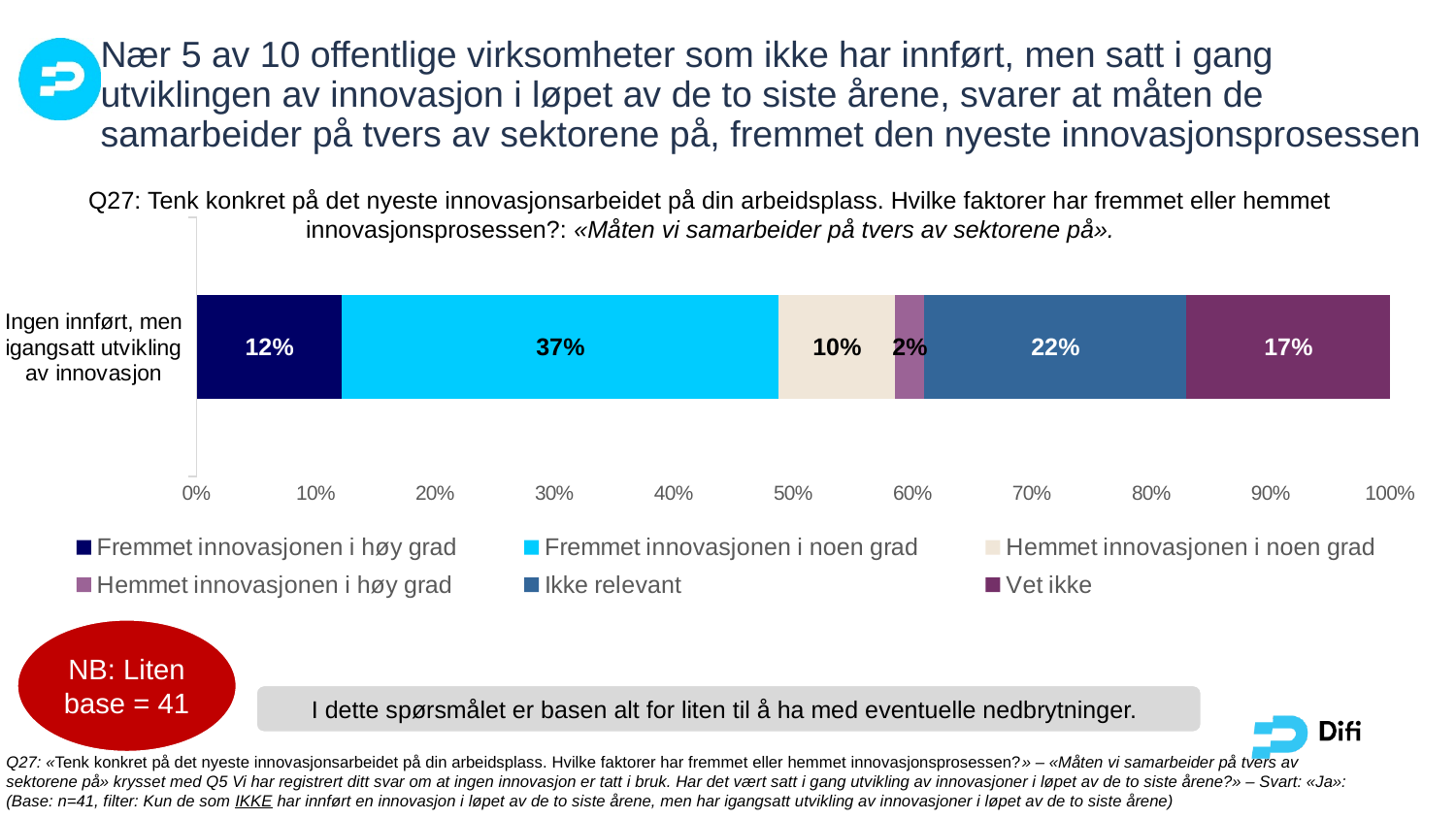
Which response category has the largest share of the bar? Fremmet innovasjonen i noen grad What is the difference in percentage points between "Fremmet innovasjonen i noen grad" and "Ikke relevant"? 15 percentage points How many series does the legend list? 6 What kind of chart is shown on the slide? Stacked bar chart Which response category has the smallest share of the bar? Hemmet innovasjonen i høy grad What percentage of respondents answered "Hemmet innovasjonen i noen grad"? 10% What percentage of respondents answered "Fremmet innovasjonen i noen grad"? 37% What percentage of respondents answered "Vet ikke"? 17% What percentage of respondents answered "Ikke relevant"? 22% What percentage of respondents answered "Hemmet innovasjonen i høy grad"? 2% Which is larger: the share for "Vet ikke" or the share for "Fremmet innovasjonen i høy grad"? Vet ikke What percentage of respondents answered "Fremmet innovasjonen i høy grad"? 12%